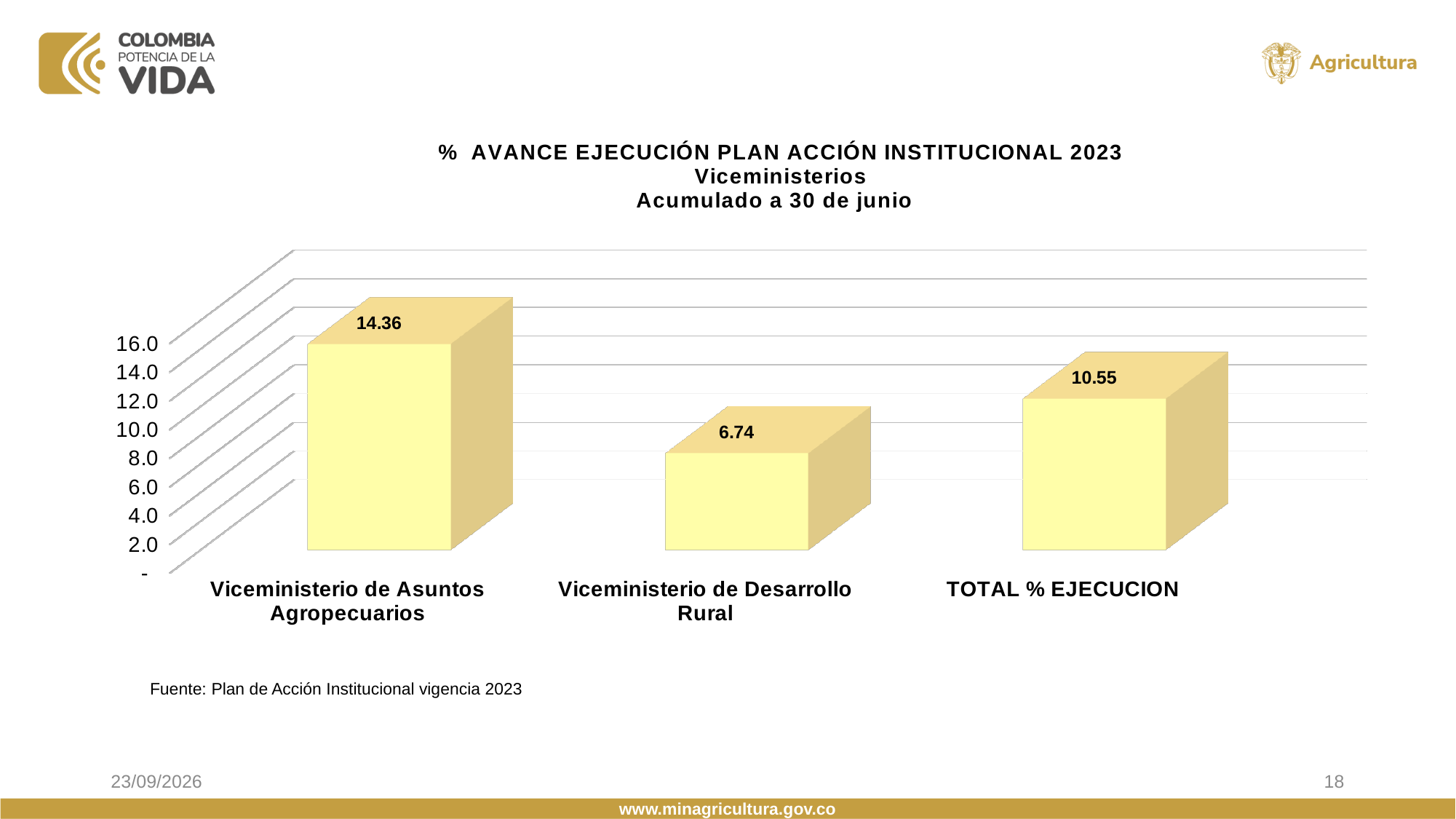
What is the value for Viceministerio de Desarrollo Rural? 6.74 What is the value for Viceministerio de Asuntos Agropecuarios? 14.36 Which is larger, the value for Viceministerio de Desarrollo Rural or the value for TOTAL % EJECUCION? TOTAL % EJECUCION What is the value for TOTAL % EJECUCION? 10.55 Which category has the highest value? Viceministerio de Asuntos Agropecuarios What is the difference between the values for Viceministerio de Asuntos Agropecuarios and Viceministerio de Desarrollo Rural? 7.62 What kind of chart is shown on the slide? bar chart Is the value for Viceministerio de Desarrollo Rural greater or less than 8.0? less What is the title of the chart? % AVANCE EJECUCIÓN PLAN ACCIÓN INSTITUCIONAL 2023 Viceministerios Acumulado a 30 de junio How many categories are shown on the chart? 3 What is the difference between the values for Viceministerio de Asuntos Agropecuarios and TOTAL % EJECUCION? 3.81 Which category has the lowest value? Viceministerio de Desarrollo Rural